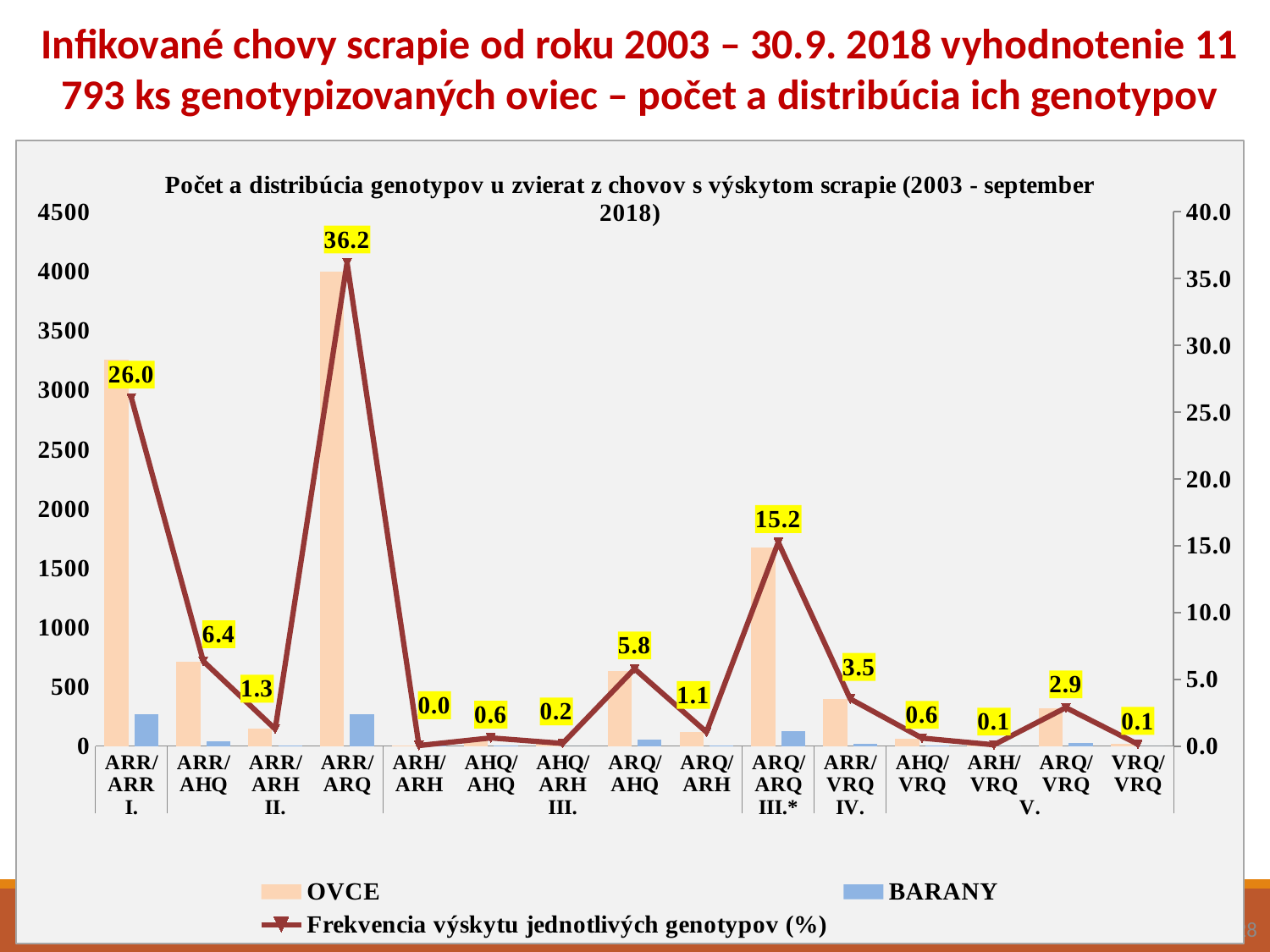
How many genotype categories are shown on the x axis? 15 What kind of chart is shown on the slide? Combination bar and line chart How many series does the legend list? 3 Which has a higher frequency of occurrence (%): ARR/AHQ or ARQ/AHQ? ARR/AHQ What is the frequency of occurrence (%) shown for the ARR/VRQ genotype? 3.5 Is the OVCE bar for ARQ/ARQ greater or less than 1500? greater Which genotype has the highest frequency of occurrence (%) on the line? ARR/ARQ Is the OVCE bar for ARR/ARQ greater or less than 3500? greater What is the difference between the frequency values for ARR/ARQ and ARR/ARR? 10.2 What is the frequency of occurrence (%) shown for the ARR/ARQ genotype? 36.2 Which genotype has the lowest frequency of occurrence (%) on the line? ARH/ARH What is the frequency of occurrence (%) shown for the ARQ/ARQ genotype? 15.2